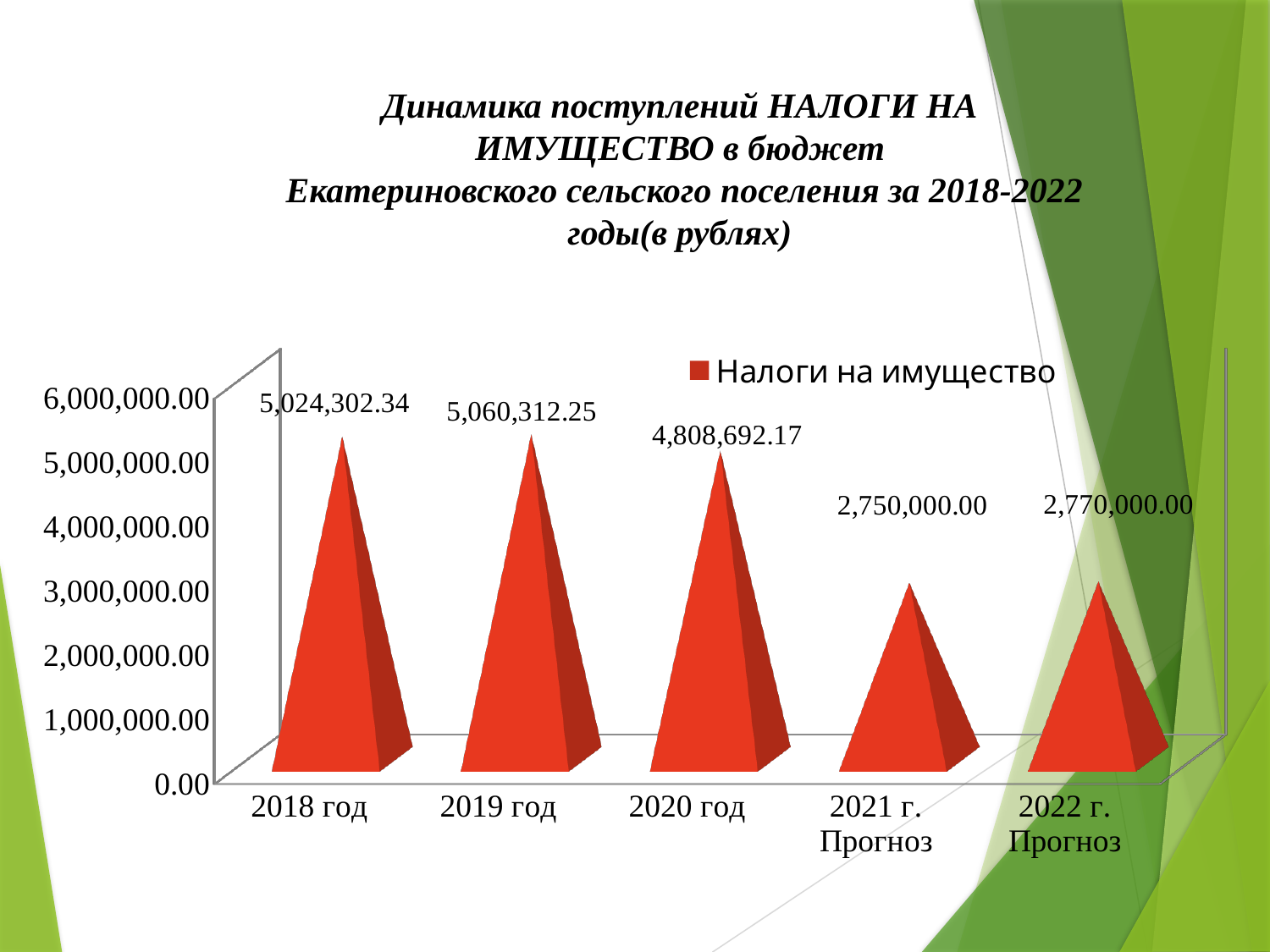
What is the difference between the values for 2022 г. Прогноз and 2021 г. Прогноз? 20,000.00 What is the value for 2018 год? 5,024,302.34 Which is larger, the value for 2018 год or the value for 2020 год? 2018 год How many categories are shown on the x axis? 5 Is the value for 2021 г. Прогноз greater or less than 3,000,000.00? less What kind of chart is shown on the slide? bar chart What is the value for 2020 год? 4,808,692.17 What is the difference between the values for 2019 год and 2018 год? 36,009.91 Which category has the highest value? 2019 год Which category has the lowest value? 2021 г. Прогноз How many series does the legend list? 1 What is the value for 2022 г. Прогноз? 2,770,000.00